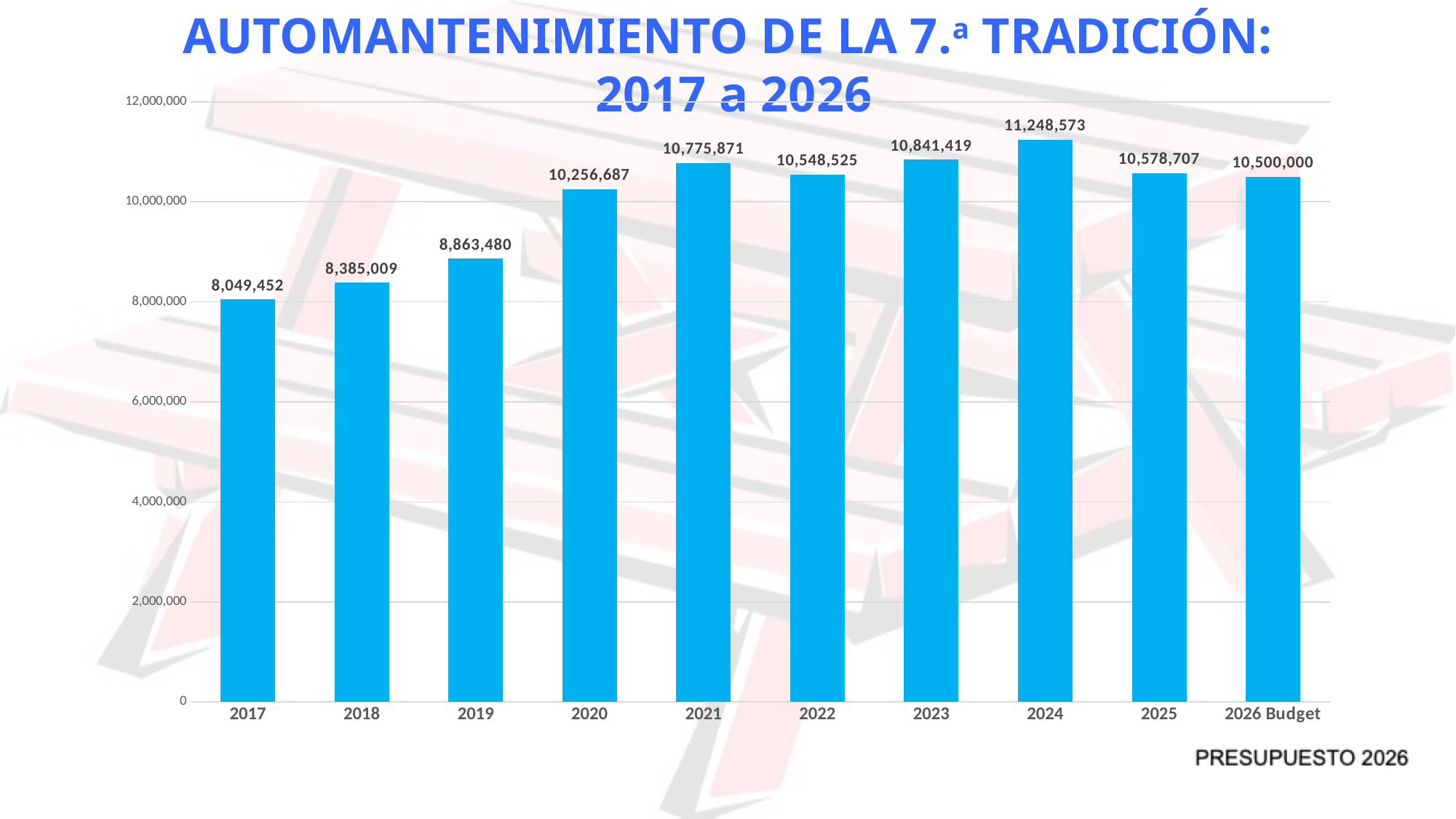
What is the value for 2020? 10,256,687 What is the difference between the values for 2024 and 2017? 3,199,121 What is the value for 2017? 8,049,452 Which year has the highest value? 2024 Is the value for 2019 greater or less than 10,000,000? less What is the value for 2026 Budget? 10,500,000 How many bars are shown in the chart? 10 What kind of chart is shown on the slide? bar chart What is the difference between the values for 2018 and 2017? 335,557 What is the value for 2024? 11,248,573 Which year has the lowest value? 2017 Which is larger, the value for 2021 or the value for 2022? 2021